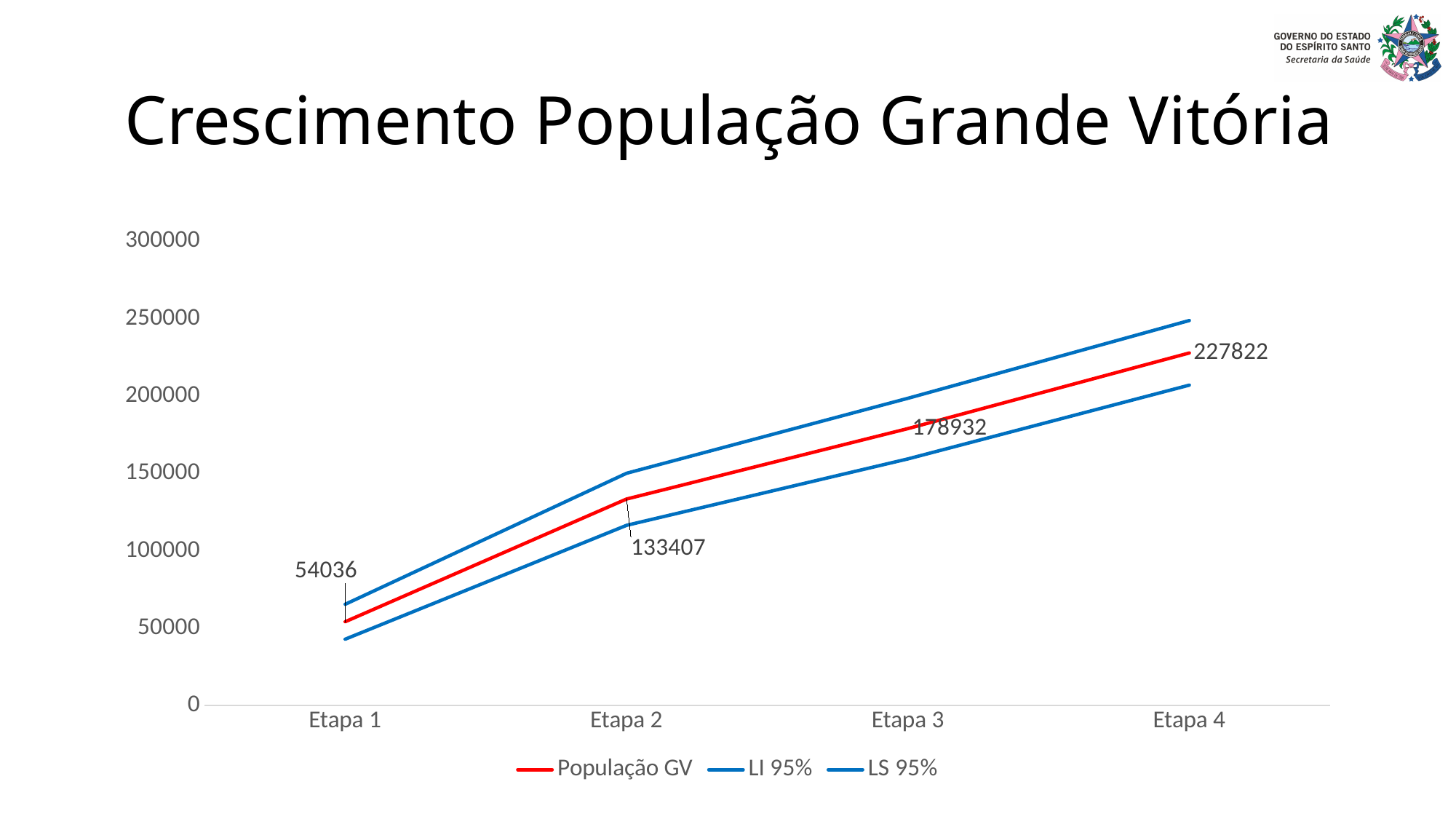
What kind of chart is shown on the slide? Line chart What is the difference between População GV at Etapa 4 and at Etapa 1? 173786 What is the value of População GV at Etapa 2? 133407 What is the value of População GV at Etapa 3? 178932 At which Etapa is População GV highest? Etapa 4 Is the value of LS 95% at Etapa 4 greater or less than 200000? greater What is the value of População GV at Etapa 1? 54036 Is the value of LI 95% at Etapa 1 greater or less than 50000? less What is the difference between População GV at Etapa 2 and at Etapa 1? 79371 What is the value of População GV at Etapa 4? 227822 At which Etapa is População GV lowest? Etapa 1 How many series does the legend list? 3